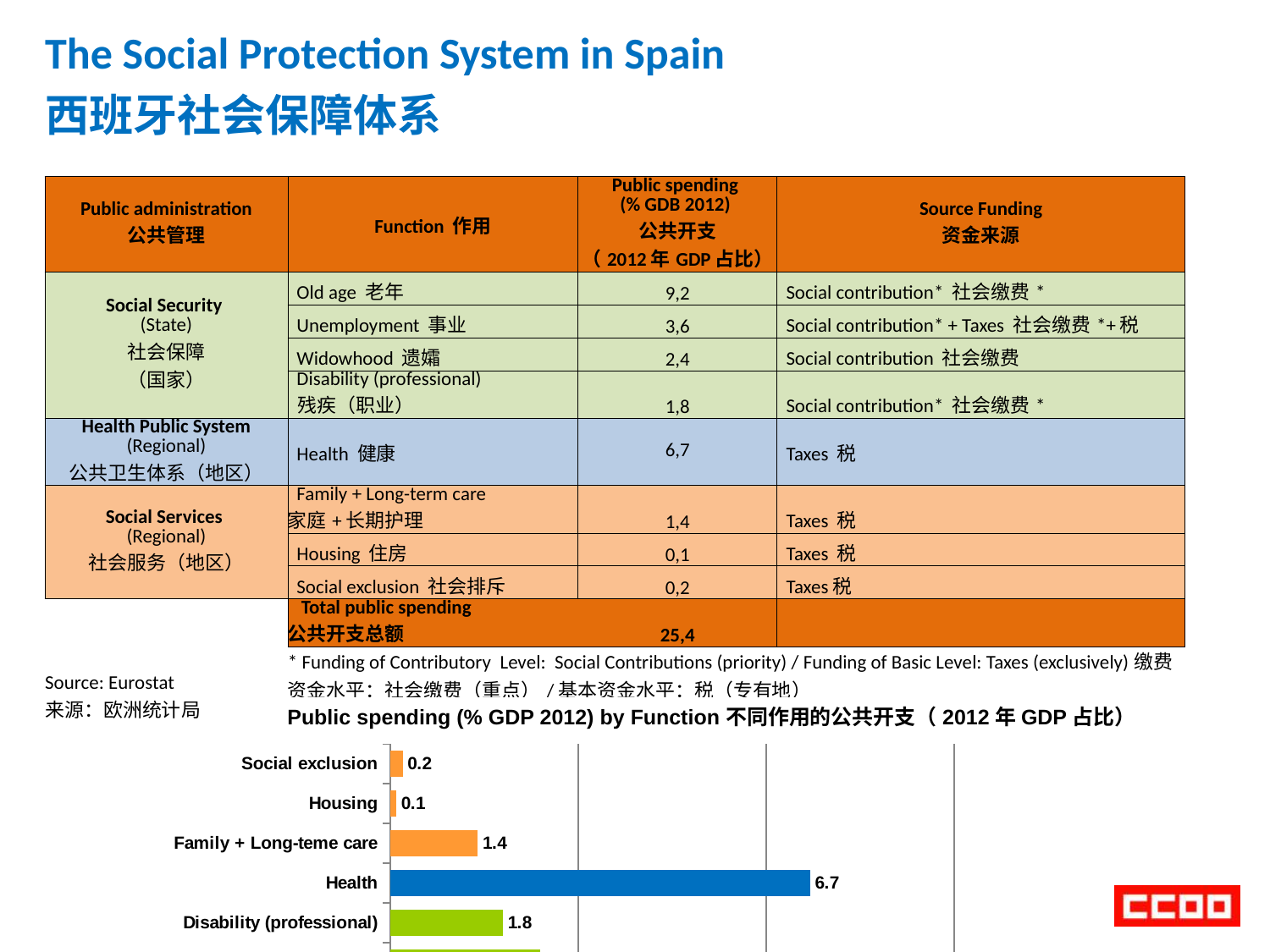
What is the difference between the values for Family + Long-teme care and Social exclusion in the bar chart? 1.2 What is the value for Social exclusion in the bar chart? 0.2 What kind of chart is shown on the slide? Bar chart What is the difference between the values for Health and Disability (professional) in the bar chart? 4.9 Which is larger in the bar chart, Disability (professional) or Family + Long-teme care? Disability (professional) What is the value for Housing in the bar chart? 0.1 What is the value for Disability (professional) in the bar chart? 1.8 What is the value for Family + Long-teme care in the bar chart? 1.4 Which labelled category in the bar chart has the highest value? Health Which labelled category in the bar chart has the lowest value? Housing What is the value for Health in the bar chart? 6.7 What is the title of the bar chart? Public spending (% GDP 2012) by Function 不同作用的公共开支（2012年 GDP 占比）